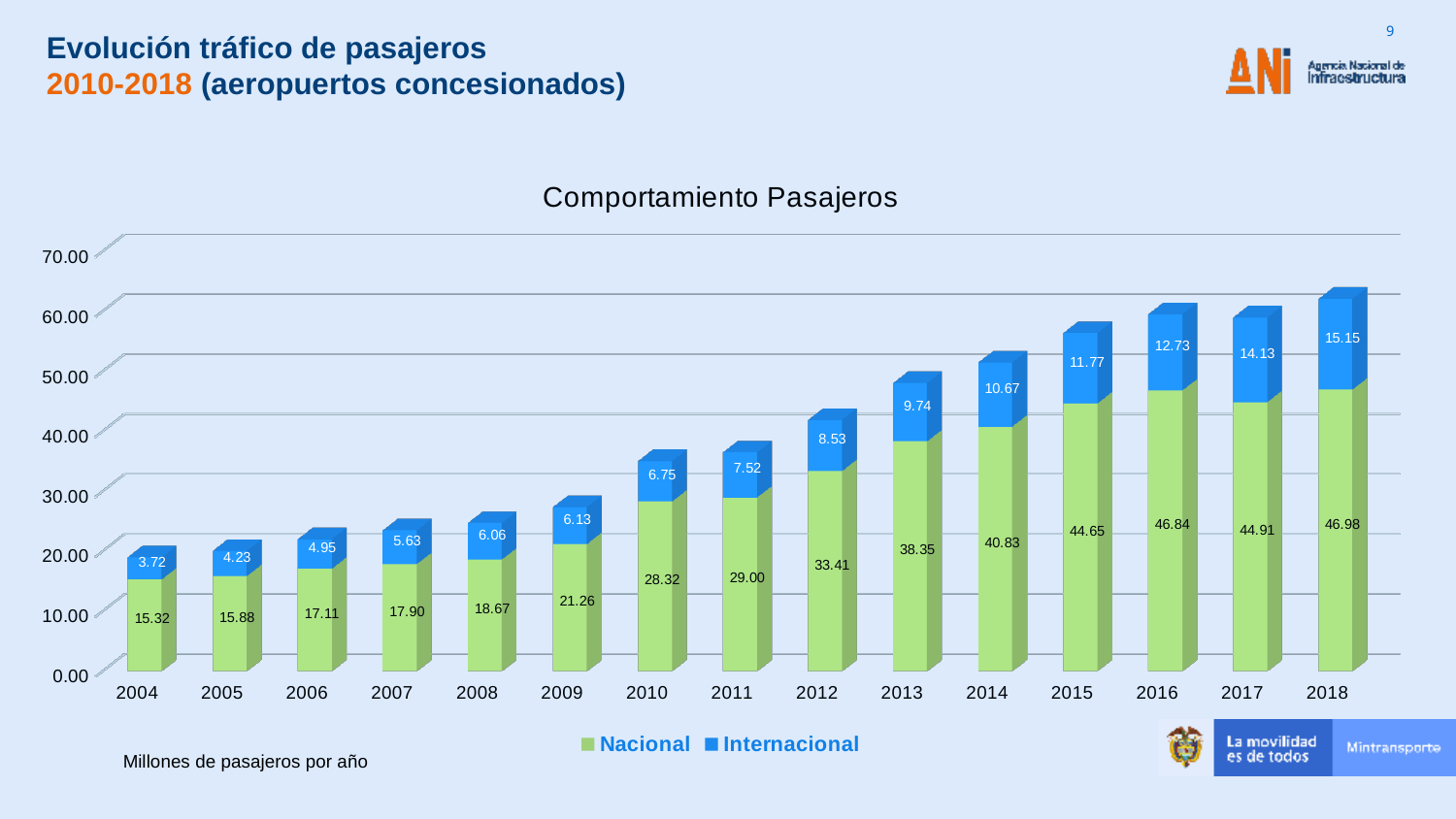
In which year is the Nacional value lowest? 2004 How many series does the legend list? 2 What kind of chart is shown? Stacked bar chart How many years are shown on the x axis? 15 What is the difference between the Internacional values for 2018 and 2017? 1.02 What is the total of the stacked bar for 2018? 62.13 What is the Nacional value for 2010? 28.32 In which year is the Internacional value highest? 2018 Which is larger, the Nacional value for 2015 or for 2017? 2017 Is the total height of the 2013 bar greater or less than 40.00? greater What is the Internacional value for 2018? 15.15 What is the title of the chart? Comportamiento Pasajeros